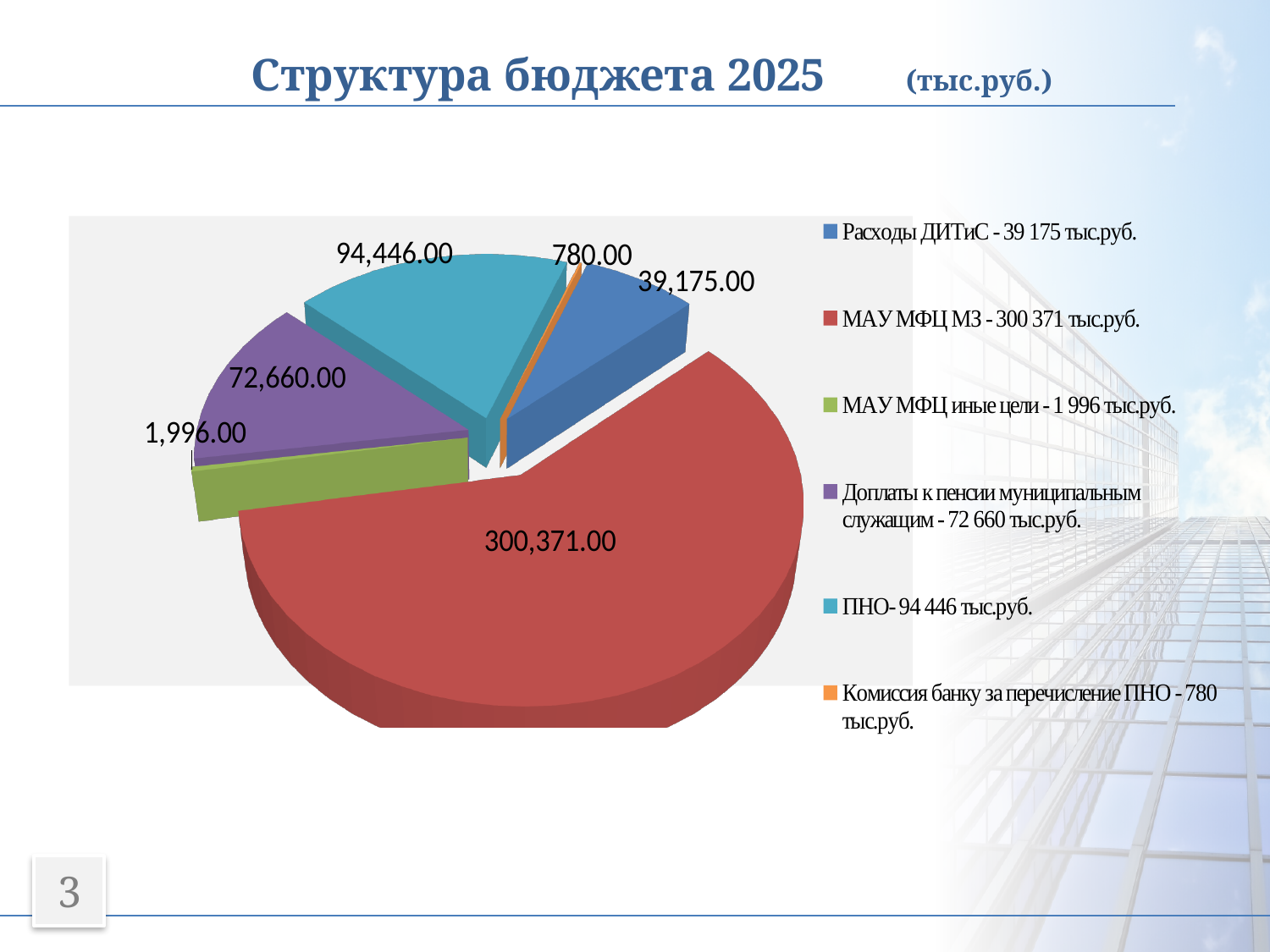
What is the value shown for Комиссия банку за перечисление ПНО? 780.00 How many slices does the pie chart have? 6 What is the value shown for Расходы ДИТиС? 39,175.00 What type of chart is shown on the slide? Pie chart What is the title of the slide containing the chart? Структура бюджета 2025 (тыс.руб.) What is the value shown for ПНО? 94,446.00 What is the difference between the values for МАУ МФЦ МЗ and ПНО? 205,925.00 Which is larger, the value for Доплаты к пенсии муниципальным служащим or the value for Расходы ДИТиС? Доплаты к пенсии муниципальным служащим What is the value shown for МАУ МФЦ МЗ? 300,371.00 Which category has the smallest slice of the pie? Комиссия банку за перечисление ПНО Which category has the largest slice of the pie? МАУ МФЦ МЗ What is the difference between the values for ПНО and Доплаты к пенсии муниципальным служащим? 21,786.00